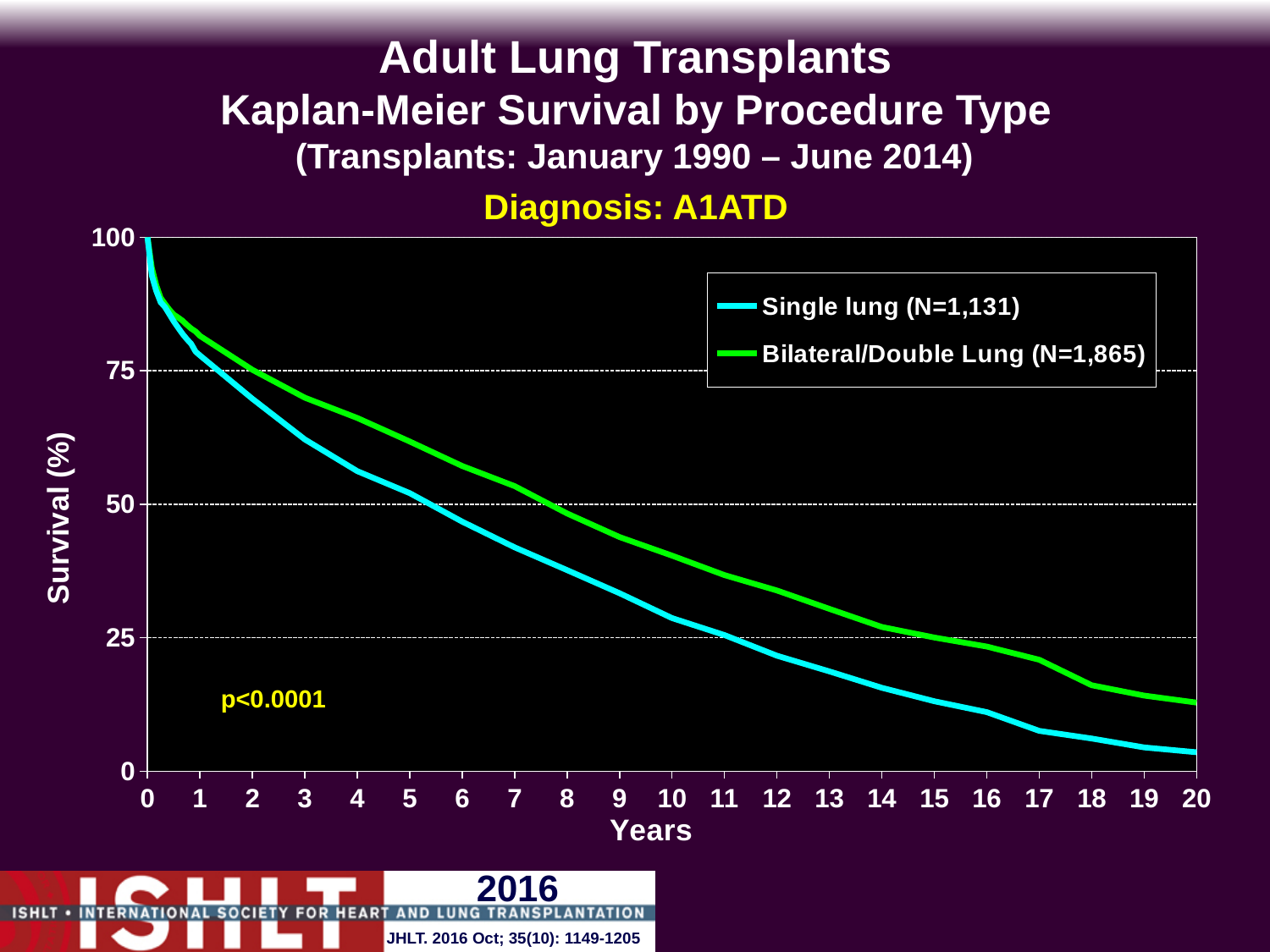
Is the survival value for Bilateral/Double Lung at 10 years greater or less than 50? less What p-value is printed on the chart? p<0.0001 Is the survival value for Bilateral/Double Lung at 20 years greater or less than 25? less Is the survival value for Single lung at 10 years greater or less than 25? greater What kind of chart is shown on the slide? line chart How many series does the legend list? 2 Do the survival curves rise or fall as years increase? fall At 10 years, which procedure type has the higher survival, Single lung or Bilateral/Double Lung? Bilateral/Double Lung What is the N for the Single lung group shown in the legend? N=1,131